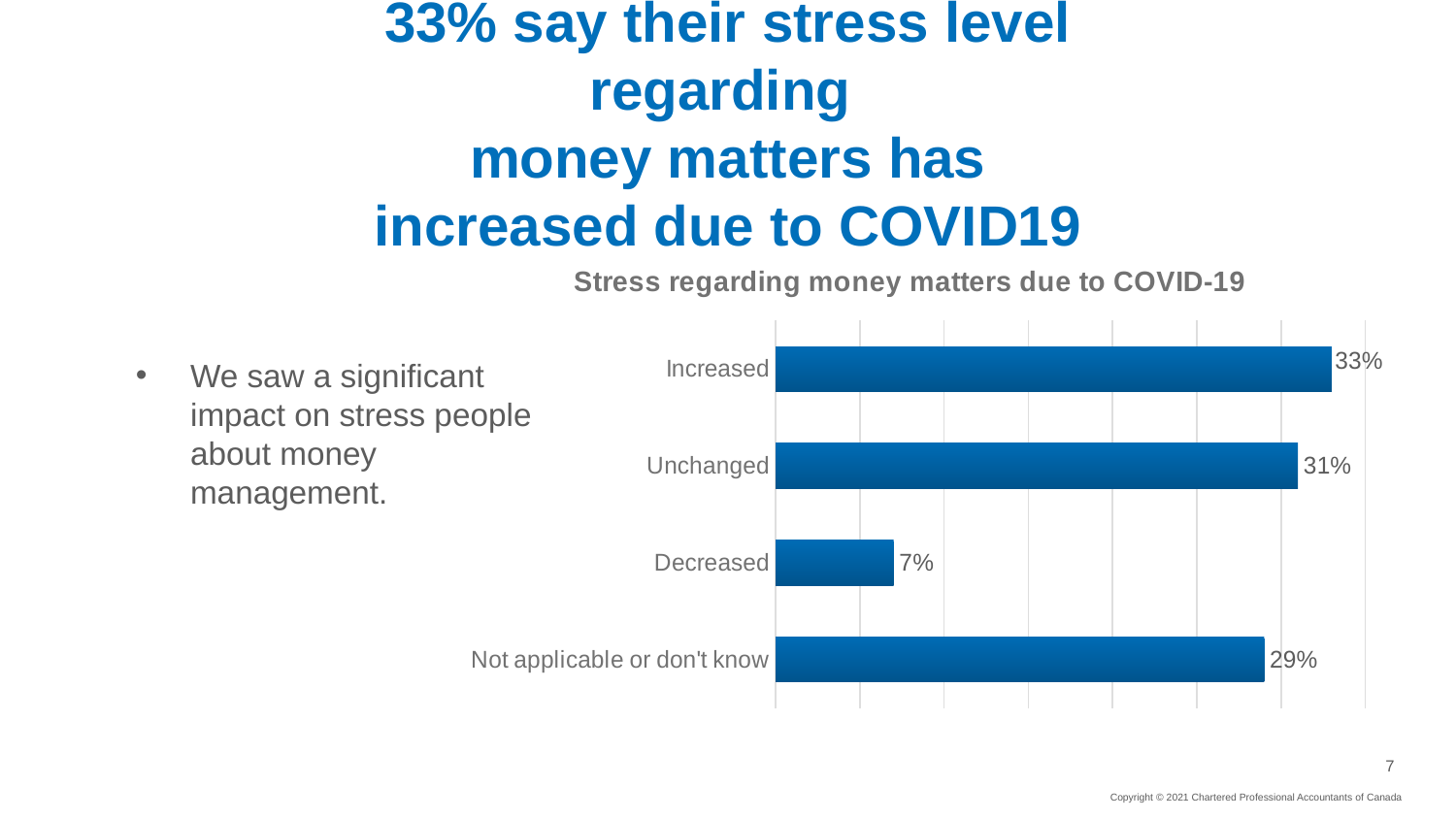
Which category has the lowest value? Decreased What is the title of the chart? Stress regarding money matters due to COVID-19 What is the difference between the 'Increased' and 'Decreased' values? 26% Which is larger, the value for 'Unchanged' or the value for 'Not applicable or don't know'? Unchanged What is the value for 'Not applicable or don't know'? 29% What is the value for 'Decreased'? 7% Which category has the highest value? Increased What is the difference between the 'Unchanged' and 'Not applicable or don't know' values? 2% What is the value for the 'Unchanged' category? 31% How many categories are shown in the chart? 4 What kind of chart is shown on the slide? Bar chart What percentage of respondents said their stress regarding money matters increased? 33%